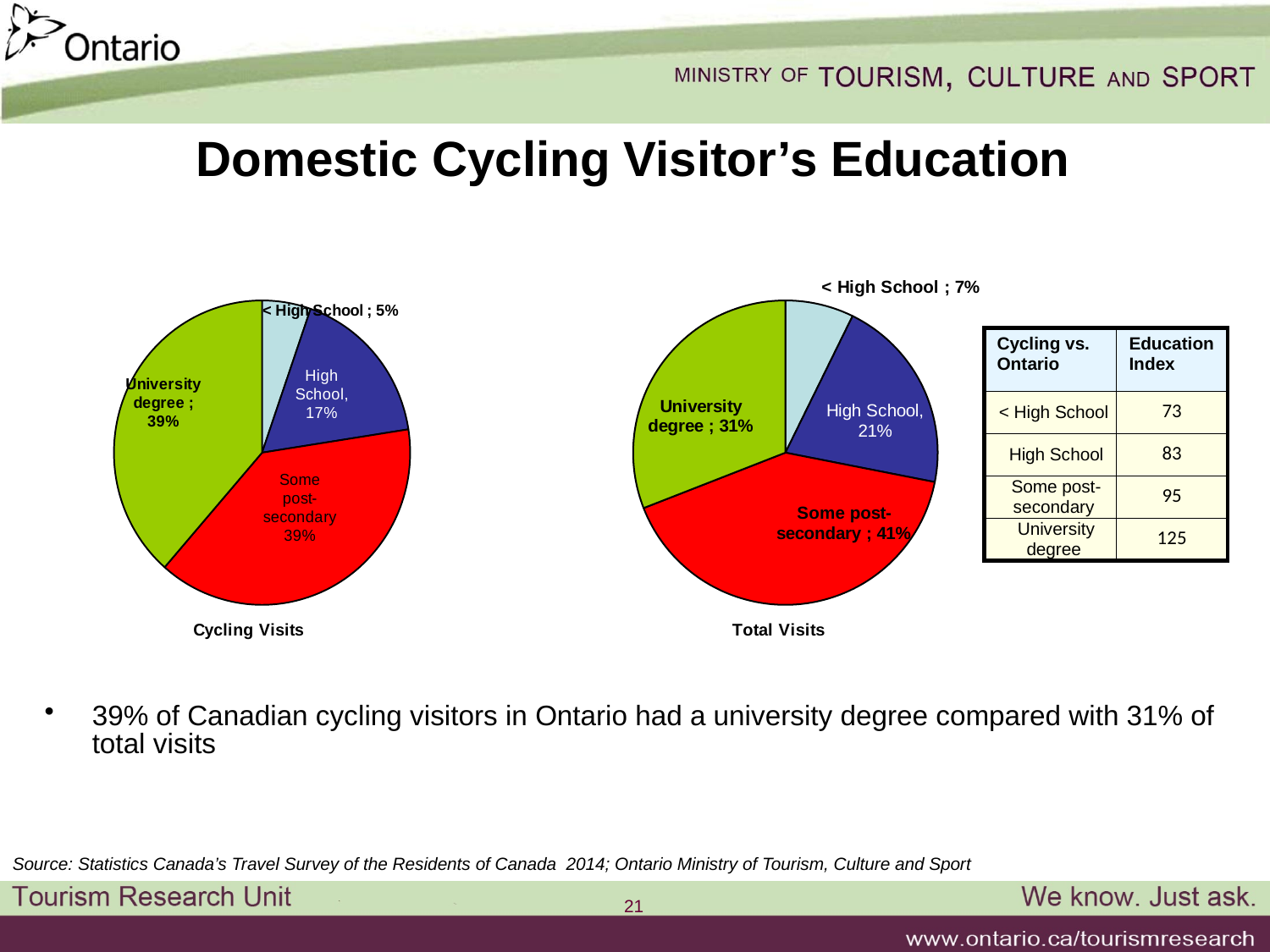
In the Total Visits pie chart, which education category has the largest share? Some post-secondary In the Total Visits pie chart, which education category has the smallest share? < High School In the Cycling Visits pie chart, which education category has the smallest share? < High School In the Total Visits pie chart, what is the difference between the High School share and the < High School share? 14 percentage points In the Cycling Visits pie chart, what share of visitors had a university degree? 39% In the Total Visits pie chart, what share of visitors had a university degree? 31% What is the difference between the university degree share in the Cycling Visits chart and in the Total Visits chart? 8 percentage points In the Cycling Visits pie chart, what is the share for High School? 17% What type of chart is used for Cycling Visits and Total Visits? Pie chart How many slices does the Cycling Visits pie chart have? 4 In the Total Visits pie chart, what is the share for Some post-secondary? 41% Which is larger: the High School share in the Cycling Visits chart or the High School share in the Total Visits chart? Total Visits